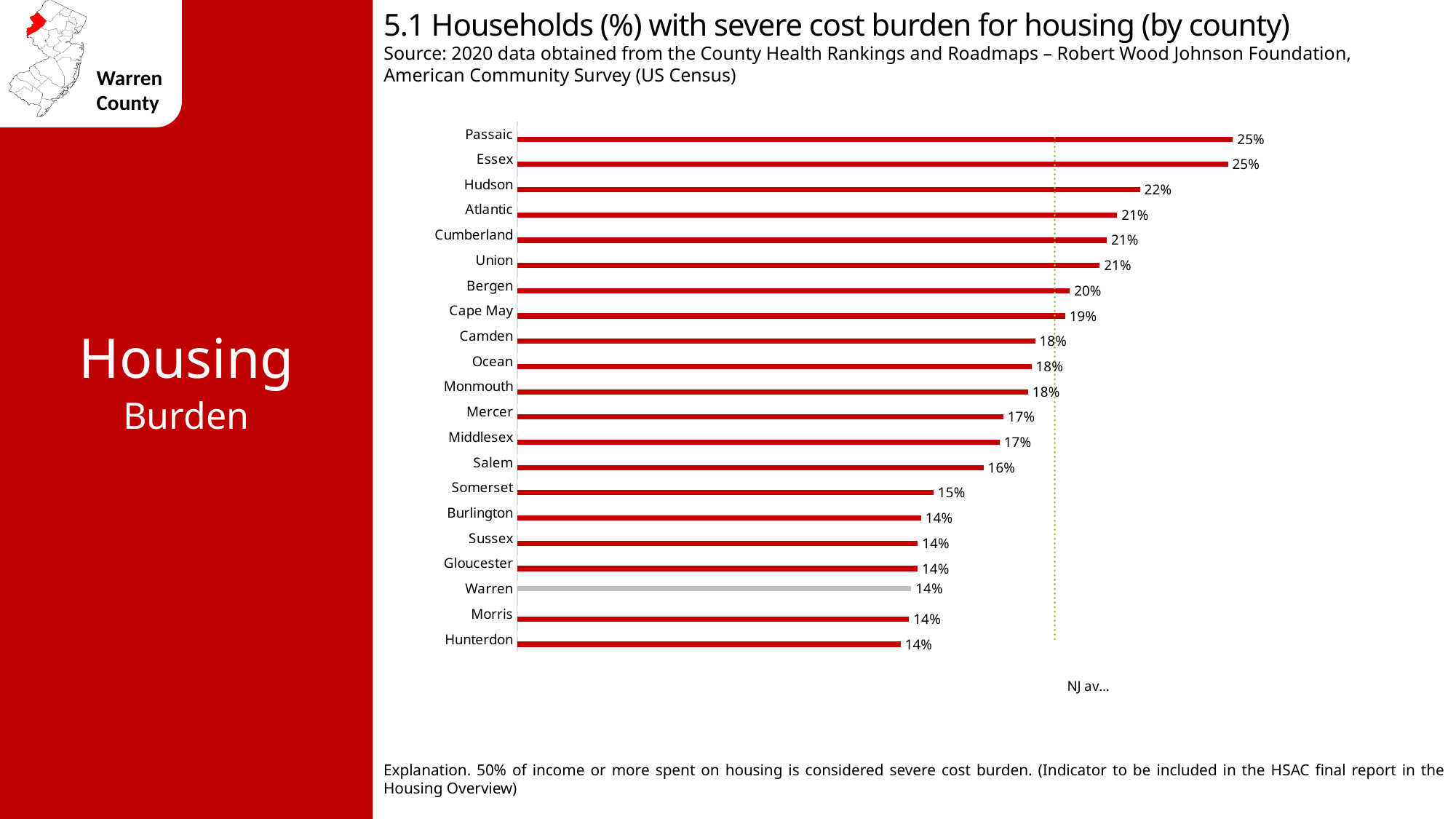
What is the value for Cape May County? 19% Which has a higher value, Somerset or Mercer? Mercer What is the difference between the values for Hudson and Warren? 8 percentage points What is the value for Salem County? 16% What kind of chart is shown on the slide? Bar chart How many counties are shown in the chart? 21 What is the value for Hudson County? 22% What is the difference between the values for Passaic and Bergen? 5 percentage points What is the value for Somerset County? 15% Which has a higher value, Hudson or Bergen? Hudson What is the value for Warren County? 14% Which county's bar is shown in gray instead of red? Warren